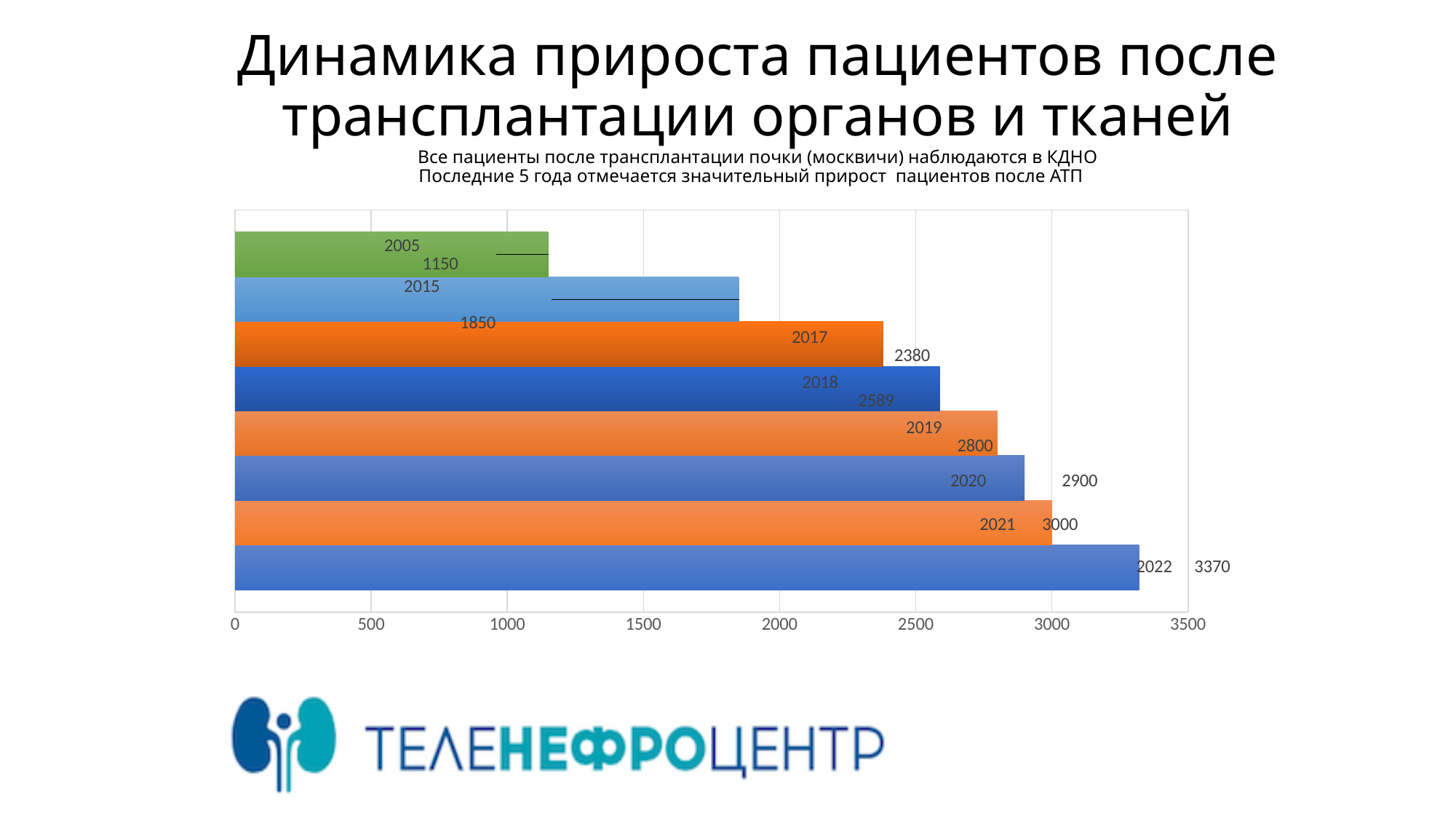
What kind of chart is shown on the slide? Bar chart What is the value for 2022? 3370 What is the highest value shown on the horizontal axis? 3500 What is the value for 2021? 3000 What is the value for 2005? 1150 How many years (bars) are shown in the chart? 8 What is the value for 2018? 2589 Which is larger, the value for 2015 or the value for 2020? 2020 Which year has the highest value? 2022 Which year has the lowest value? 2005 What is the difference between the values for 2019 and 2017? 420 Do the values rise or fall from 2005 to 2022? Rise